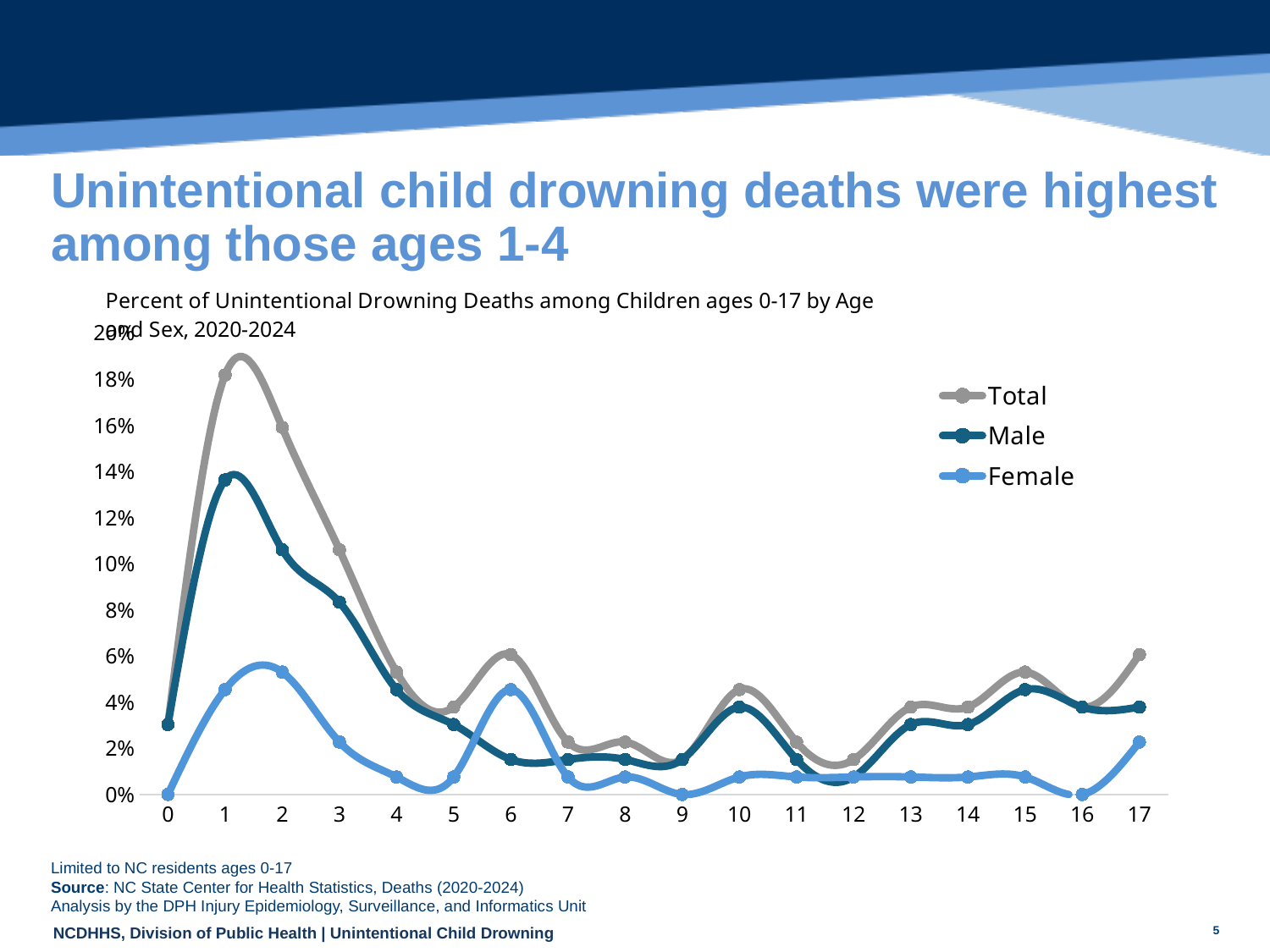
How many age categories are plotted along the x axis? 18 At which age is the Male series highest? 1 Does the Total series rise or fall from age 1 to age 4? fall What kind of chart is shown on the slide? line chart How many series does the legend list? 3 At age 6, which is larger, the Male value or the Female value? Female Is the Total value at age 1 greater or less than 16%? greater What is the title of the chart? Percent of Unintentional Drowning Deaths among Children ages 0-17 by Age and Sex, 2020-2024 What is the Female value at age 0? 0% Is the Female value at age 2 greater or less than 6%? less Is the Male value at age 3 greater or less than 6%? greater At which age is the Total series highest? 1